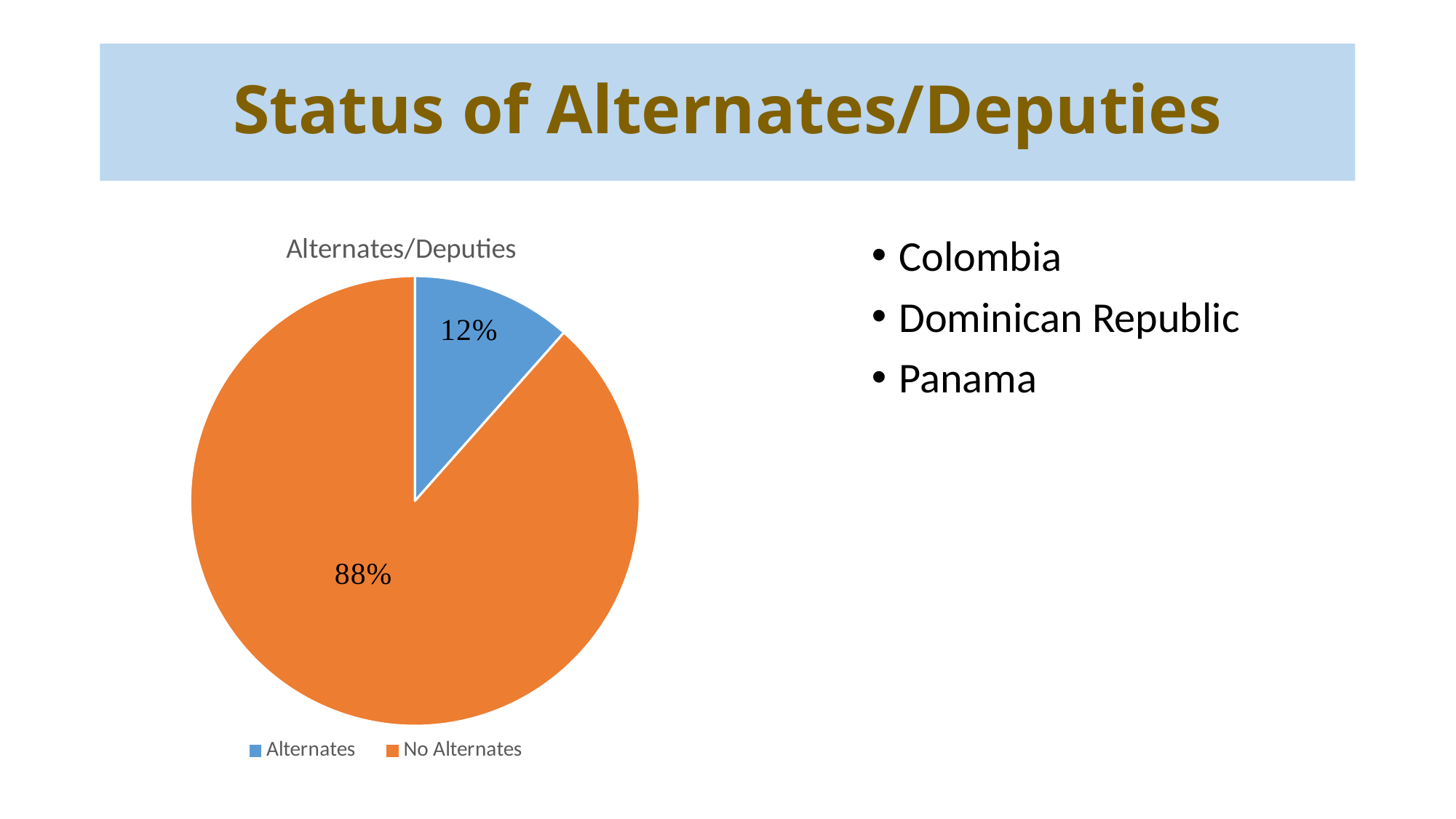
What share of the pie is labelled Alternates? 12% Which slice is the largest? No Alternates How many slices does the pie chart have? 2 Which slice is the smallest? Alternates What share of the pie is labelled No Alternates? 88% What colour is the No Alternates slice? orange What is the chart's title? Alternates/Deputies How many entries does the legend list? 2 What is the difference in percentage points between the No Alternates slice and the Alternates slice? 76 Which is larger, the Alternates slice or the No Alternates slice? No Alternates What kind of chart is shown on the slide? pie chart